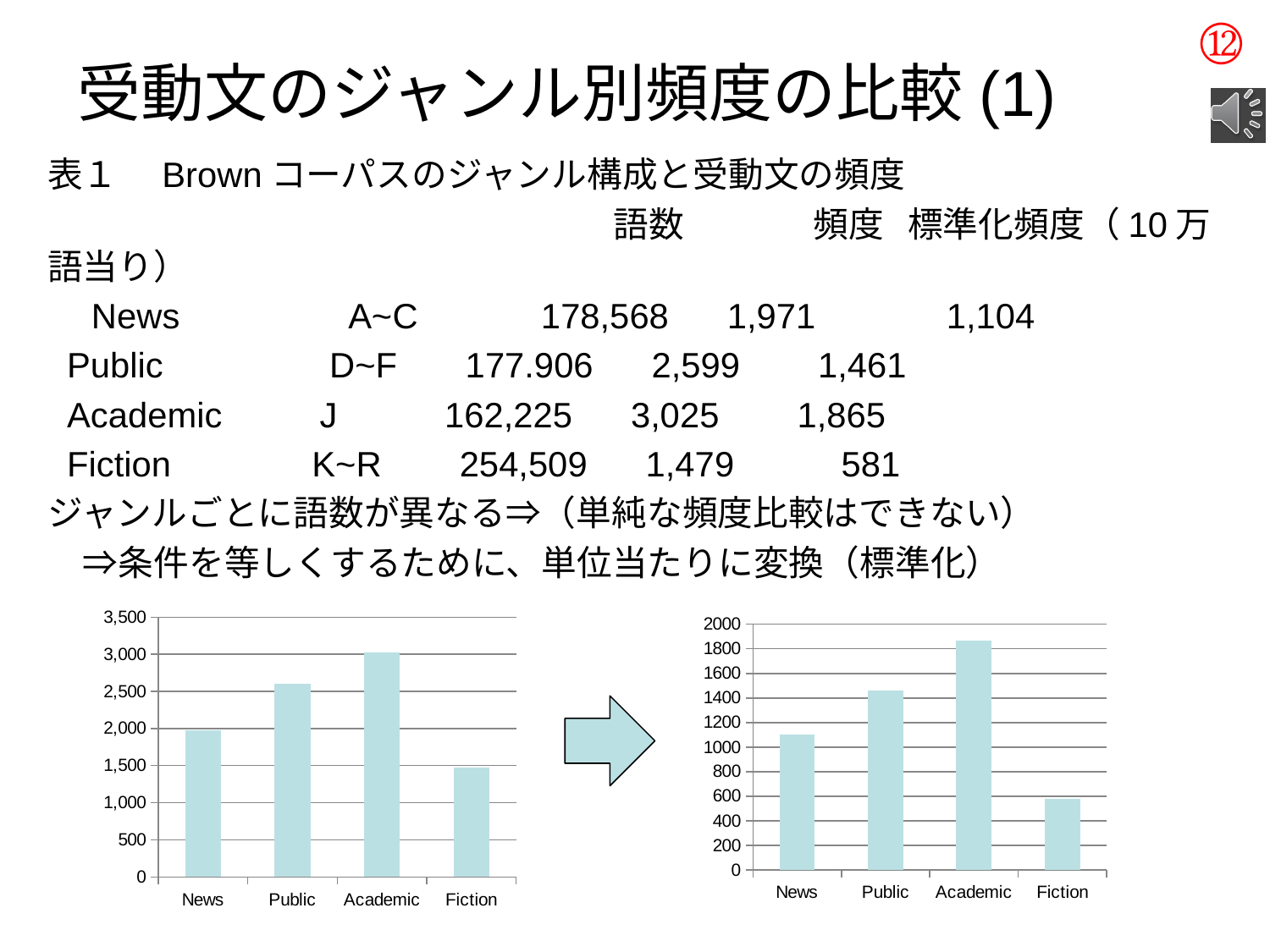
In the right chart, which category has the highest bar? Academic In the right chart, which category has the lowest bar? Fiction In the left chart, is the value for Public greater or less than 2,000? greater In the right chart, is the value for Fiction greater or less than 800? less What type of chart is the left chart on the slide? bar chart In the left chart, is the value for Fiction greater or less than 1,000? greater In the left chart, which category has the lowest bar? Fiction In the left chart, which category has the highest bar? Academic How many categories are shown on the x axis of the right chart? 4 What is the highest tick value on the y axis of the left chart? 3,500 In the right chart, which is larger, the value for Public or the value for News? Public